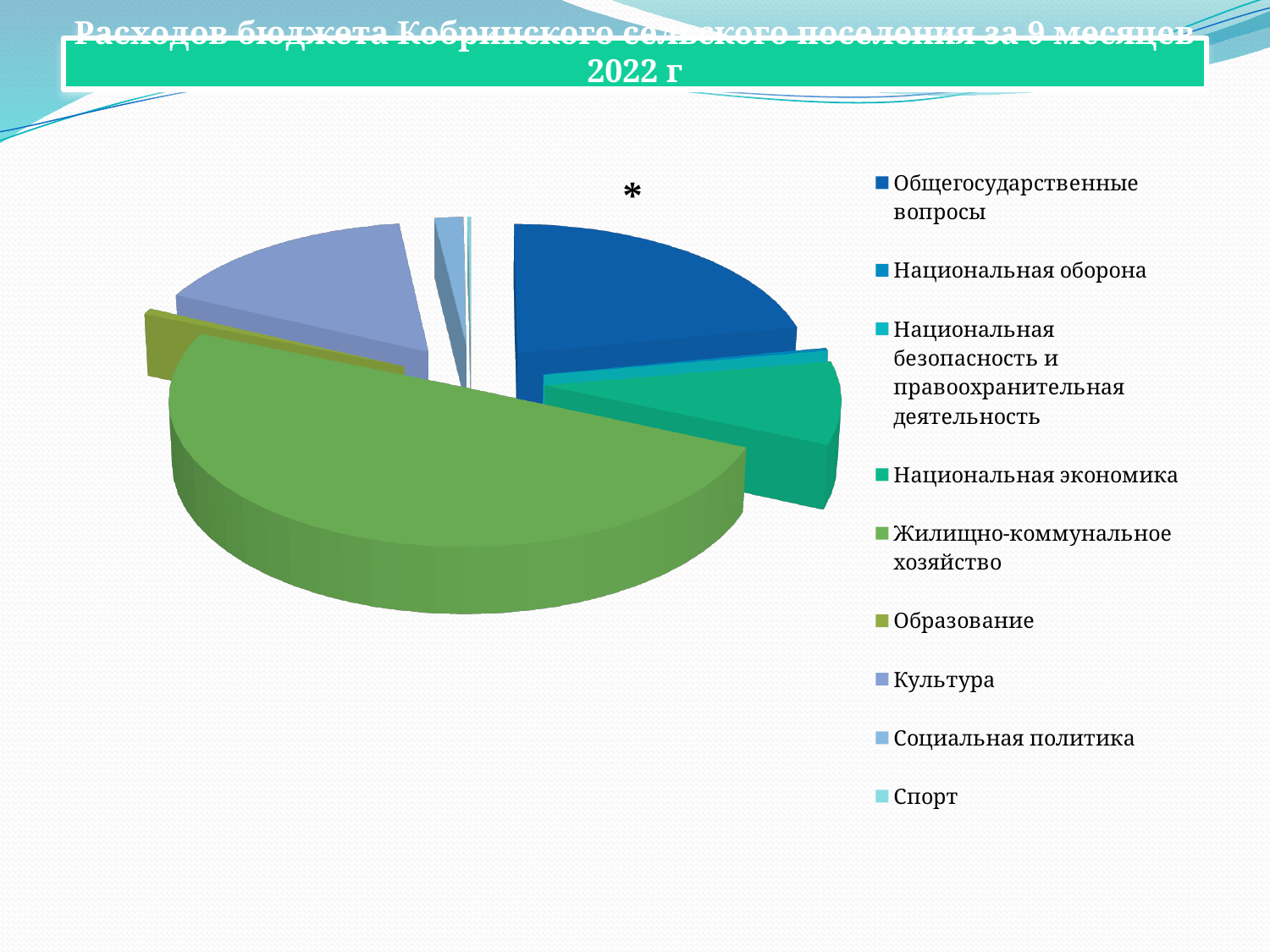
Which category has the largest slice of the pie chart? Жилищно-коммунальное хозяйство How many categories does the legend of the pie chart list? 9 Which slice is larger: Общегосударственные вопросы or Национальная экономика? Общегосударственные вопросы Which slice is larger: Культура or Образование? Культура Which category is listed first in the legend of the pie chart? Общегосударственные вопросы Which slice is larger: Жилищно-коммунальное хозяйство or Культура? Жилищно-коммунальное хозяйство What colour is the slice for Жилищно-коммунальное хозяйство in the pie chart? green What kind of chart is shown on the slide? pie chart